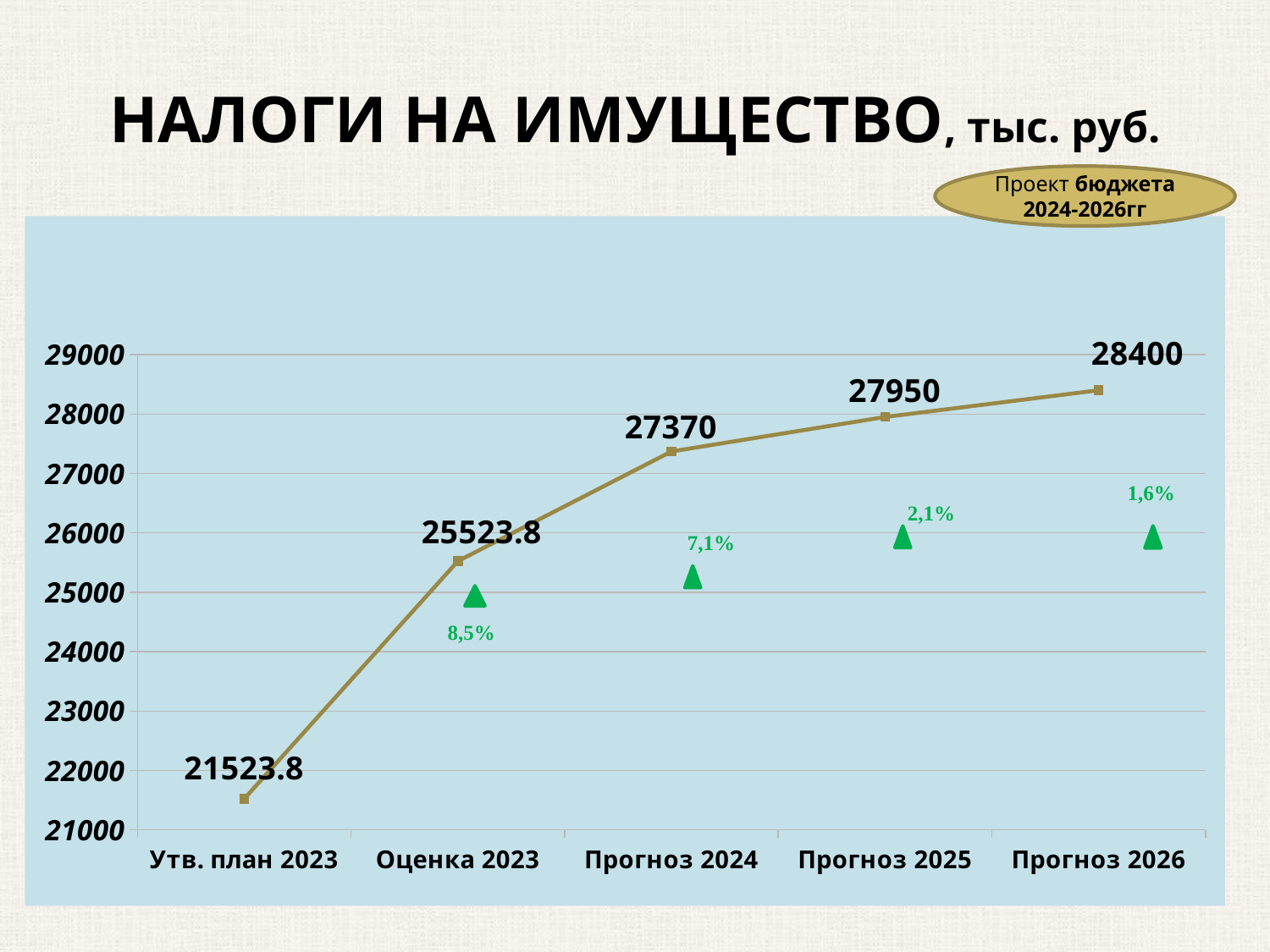
Do the values rise or fall from Утв. план 2023 to Прогноз 2026? rise How many categories are plotted on the x axis? 5 Which category has the highest value? Прогноз 2026 What kind of chart is shown on the slide? line chart What is the value for Оценка 2023? 25523.8 Which is larger, the value for Прогноз 2025 or the value for Прогноз 2024? Прогноз 2025 What is the value for Прогноз 2024? 27370 What is the difference between the values for Прогноз 2026 and Прогноз 2025? 450 What is the value for Утв. план 2023? 21523.8 What is the difference between the values for Оценка 2023 and Утв. план 2023? 4000 What is the value for Прогноз 2026? 28400 Which category has the lowest value? Утв. план 2023